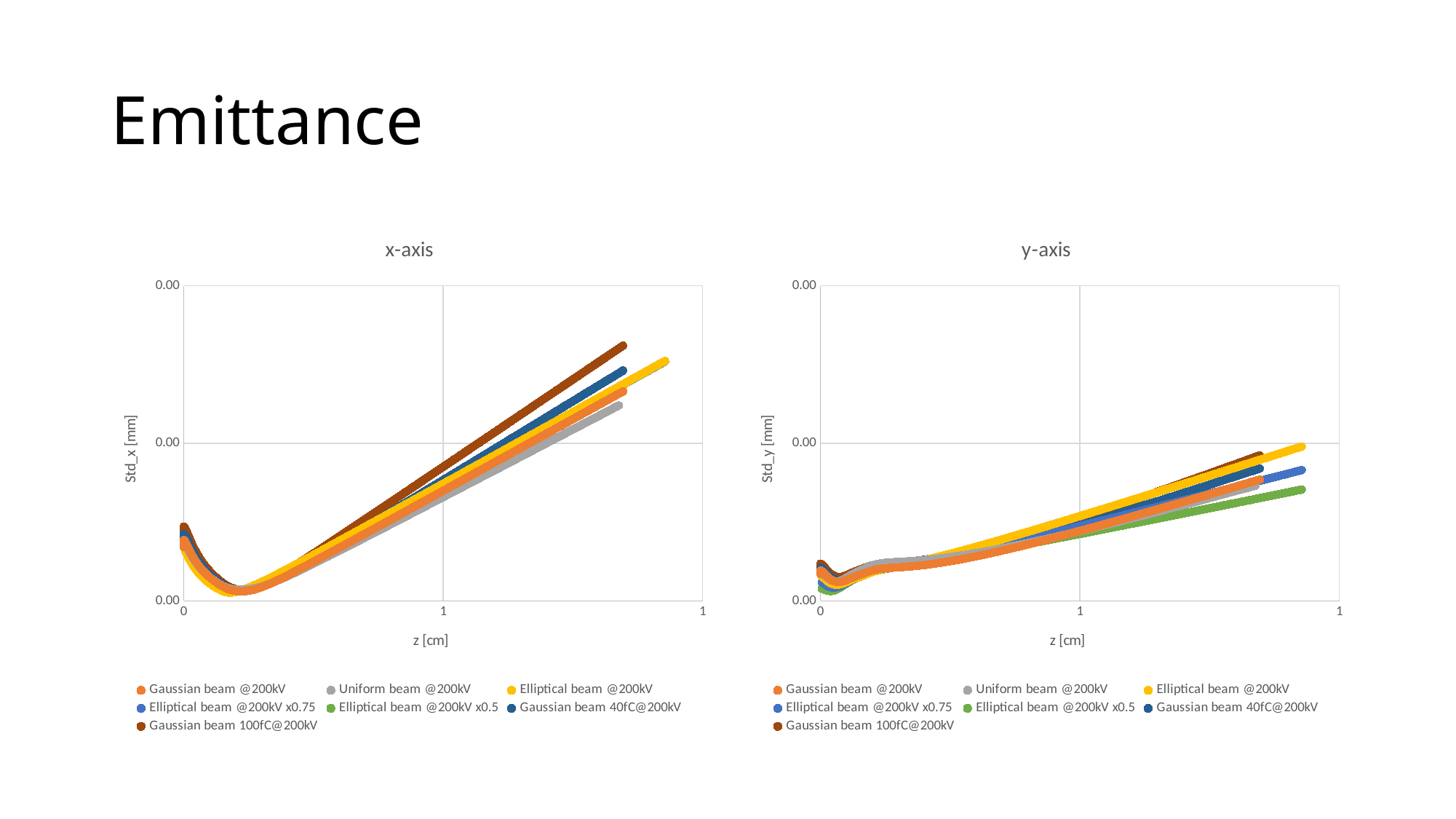
In the "y-axis" chart, do the series generally rise or fall as z increases beyond the initial dip? Rise What kind of chart is the "x-axis" chart? Line chart In the "y-axis" chart, which series reaches the highest value at the right end of the plot? Elliptical beam @200kV How many series does the legend of the "x-axis" chart list? 7 In the "y-axis" chart, which series ends lowest at the right end of the plot? Elliptical beam @200kV x0.5 What is the vertical axis label of the "y-axis" chart? Std_y [mm] In the "x-axis" chart, which ends higher at the right end: Gaussian beam 40fC@200kV or Uniform beam @200kV? Gaussian beam 40fC@200kV In the "x-axis" chart, after the initial dip, do the series rise or fall as z increases? Rise In the "y-axis" chart, which ends higher at the right end: Elliptical beam @200kV x0.75 or Elliptical beam @200kV x0.5? Elliptical beam @200kV x0.75 What is the horizontal axis label of the "x-axis" chart? z [cm] How many series does the legend of the "y-axis" chart list? 7 In the "x-axis" chart, which series reaches the highest value at the right end of the plot? Gaussian beam 100fC@200kV